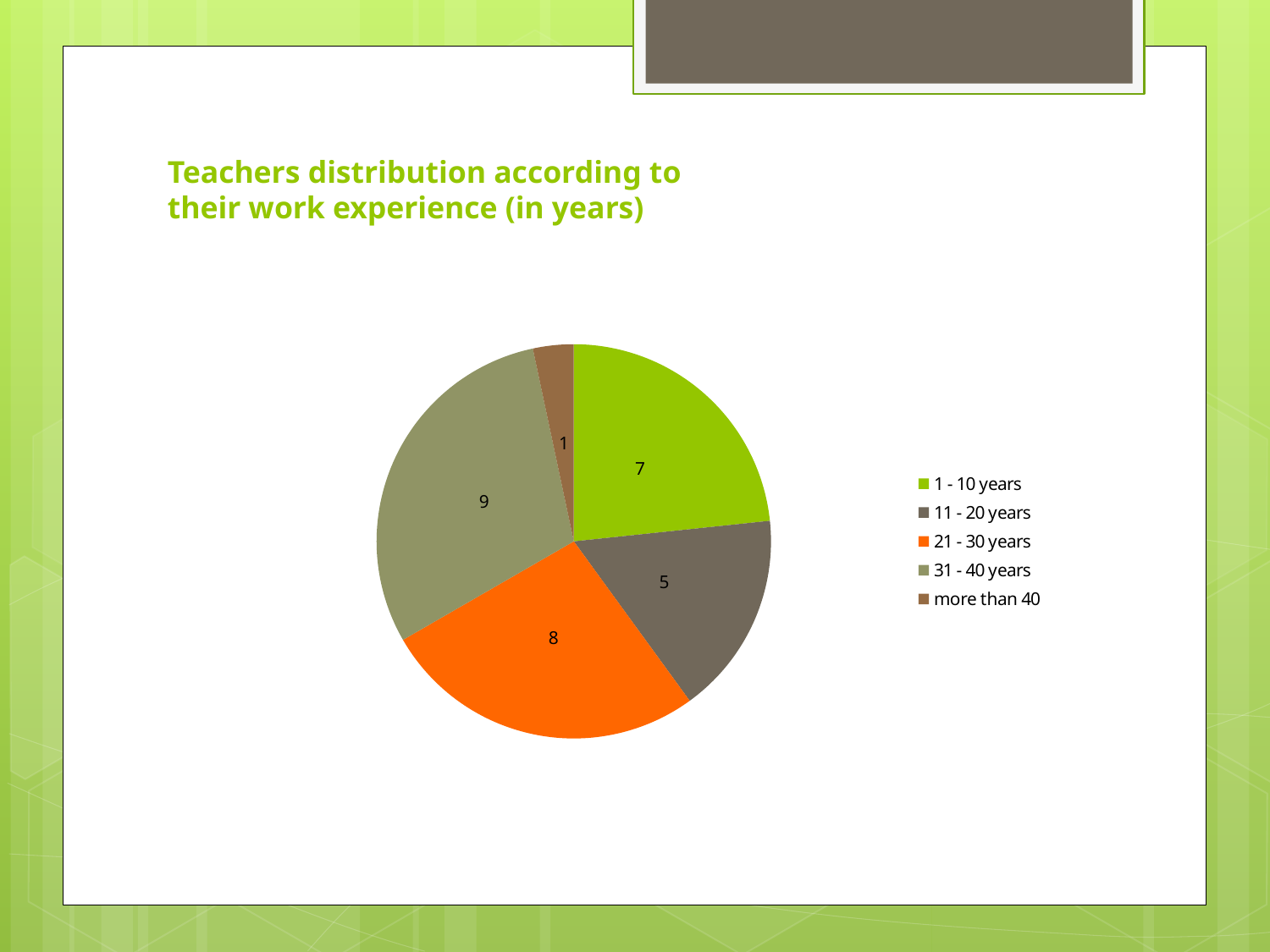
What is the value for the 11 - 20 years slice? 5 How many teachers have 1 - 10 years of work experience? 7 What type of chart is shown on the slide? pie chart What is the difference between the 31 - 40 years value and the 11 - 20 years value? 4 What is the value for the 21 - 30 years slice? 8 Which experience category has the largest slice? 31 - 40 years What share of the pie does the 31 - 40 years slice represent? 30% How many categories does the pie chart have? 5 What is the value for the more than 40 slice? 1 Which is larger, the 21 - 30 years slice or the 1 - 10 years slice? 21 - 30 years Which experience category has the smallest slice? more than 40 What is the title of the chart? Teachers distribution according to their work experience (in years)